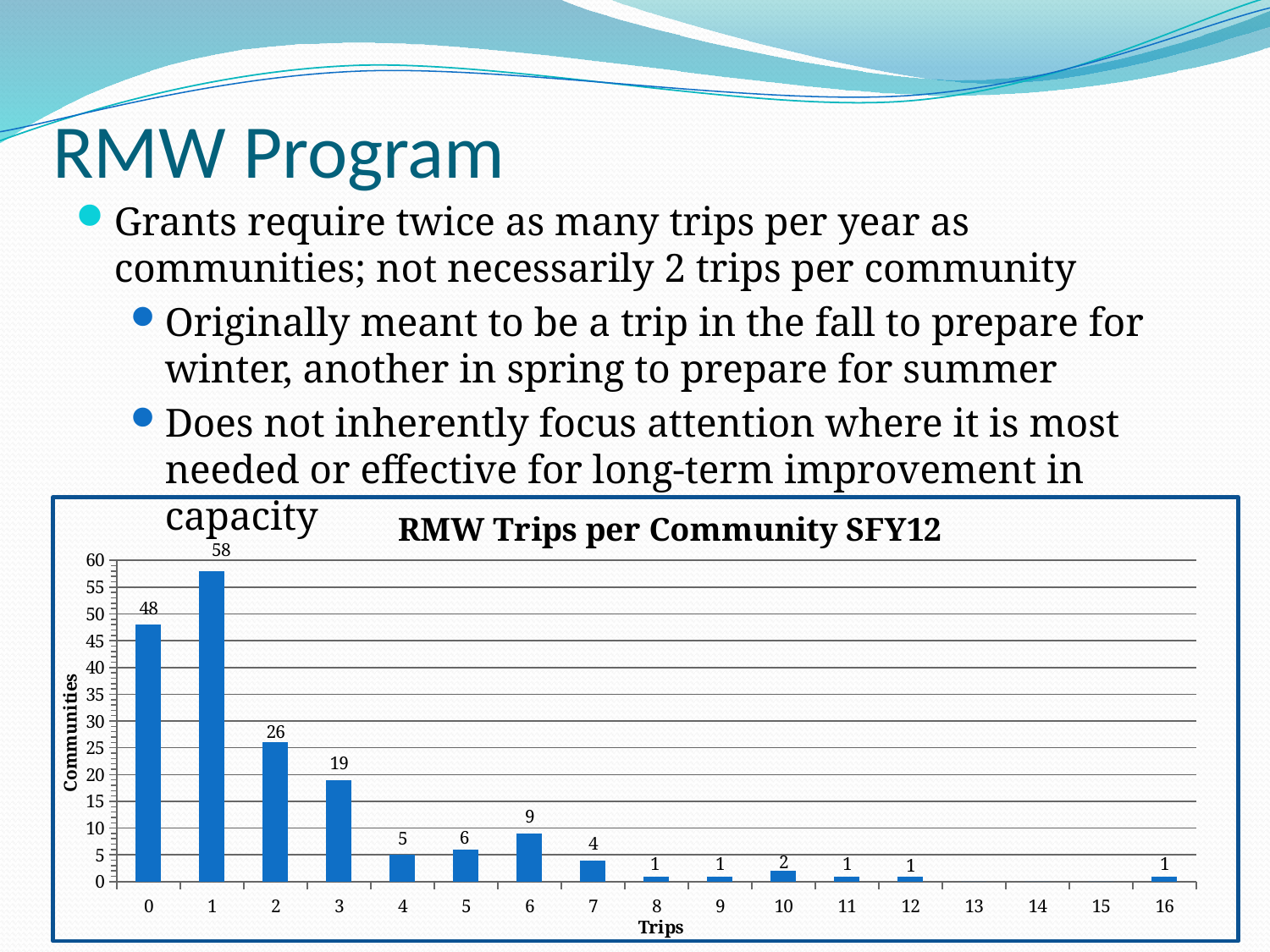
How many communities had 3 trips? 19 How many communities had 0 trips? 48 What is the difference between the number of communities with 2 trips and the number with 3 trips? 7 How many trip values are labeled on the x axis? 17 What is the title of the chart? RMW Trips per Community SFY12 How many communities had 16 trips? 1 Which has more communities: 4 trips or 5 trips? 5 trips What is the difference between the number of communities with 1 trip and the number with 0 trips? 10 How many communities had 6 trips? 9 What type of chart is shown on the slide? bar chart What is the label of the y axis? Communities Which number of trips has the highest number of communities? 1